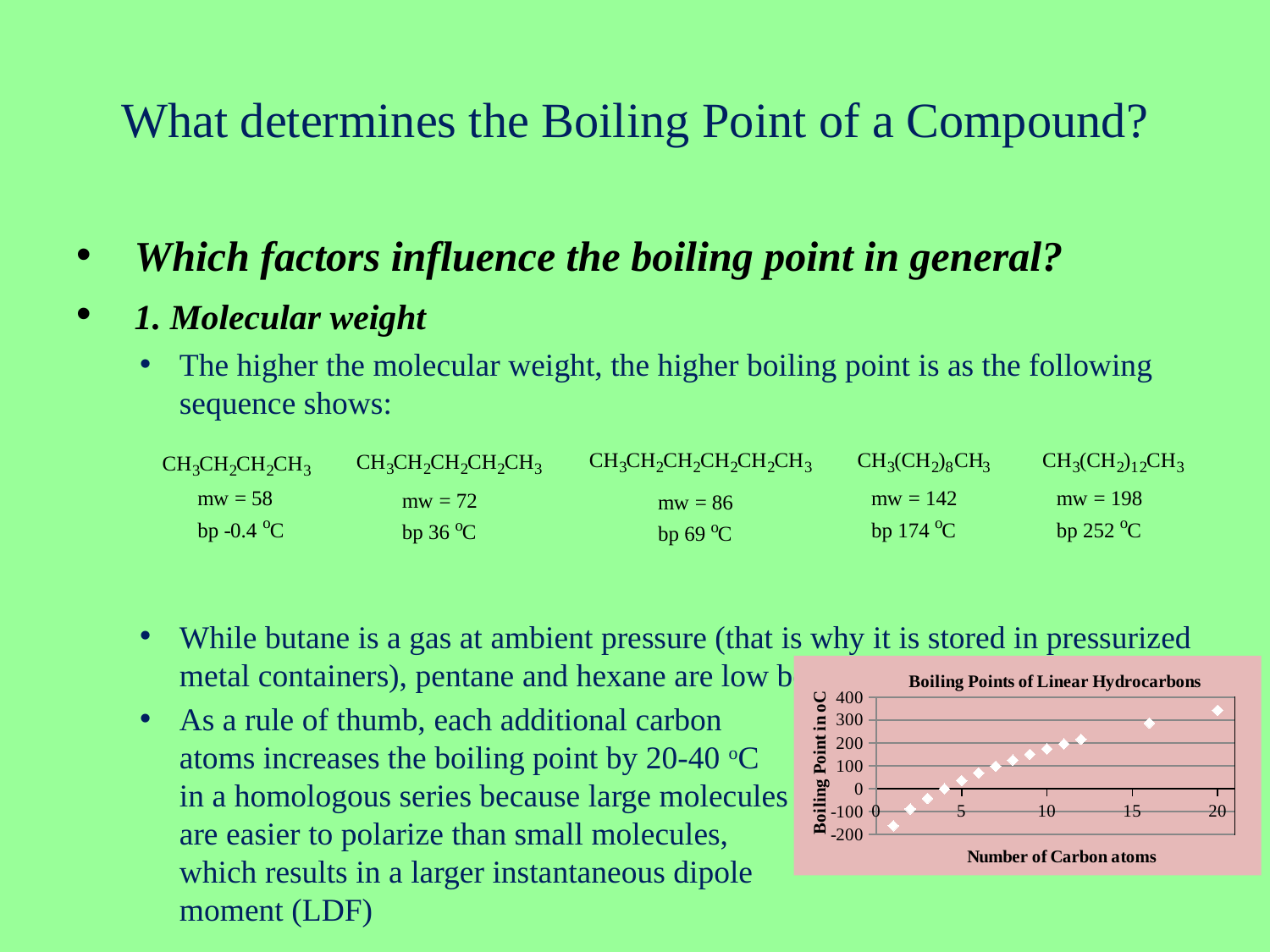
Is the boiling point at 5 carbon atoms greater or less than 0? greater Which has the higher boiling point, 10 carbon atoms or 5 carbon atoms? 10 carbon atoms What is the label of the x axis of the chart? Number of Carbon atoms Is the boiling point at 5 carbon atoms greater or less than 100? less Is the boiling point at 20 carbon atoms greater or less than 300? greater At which number of carbon atoms is the boiling point highest? 20 Do the boiling points rise or fall as the number of carbon atoms increases? rise What is the title of the chart? Boiling Points of Linear Hydrocarbons What kind of chart is shown on the slide? scatter chart